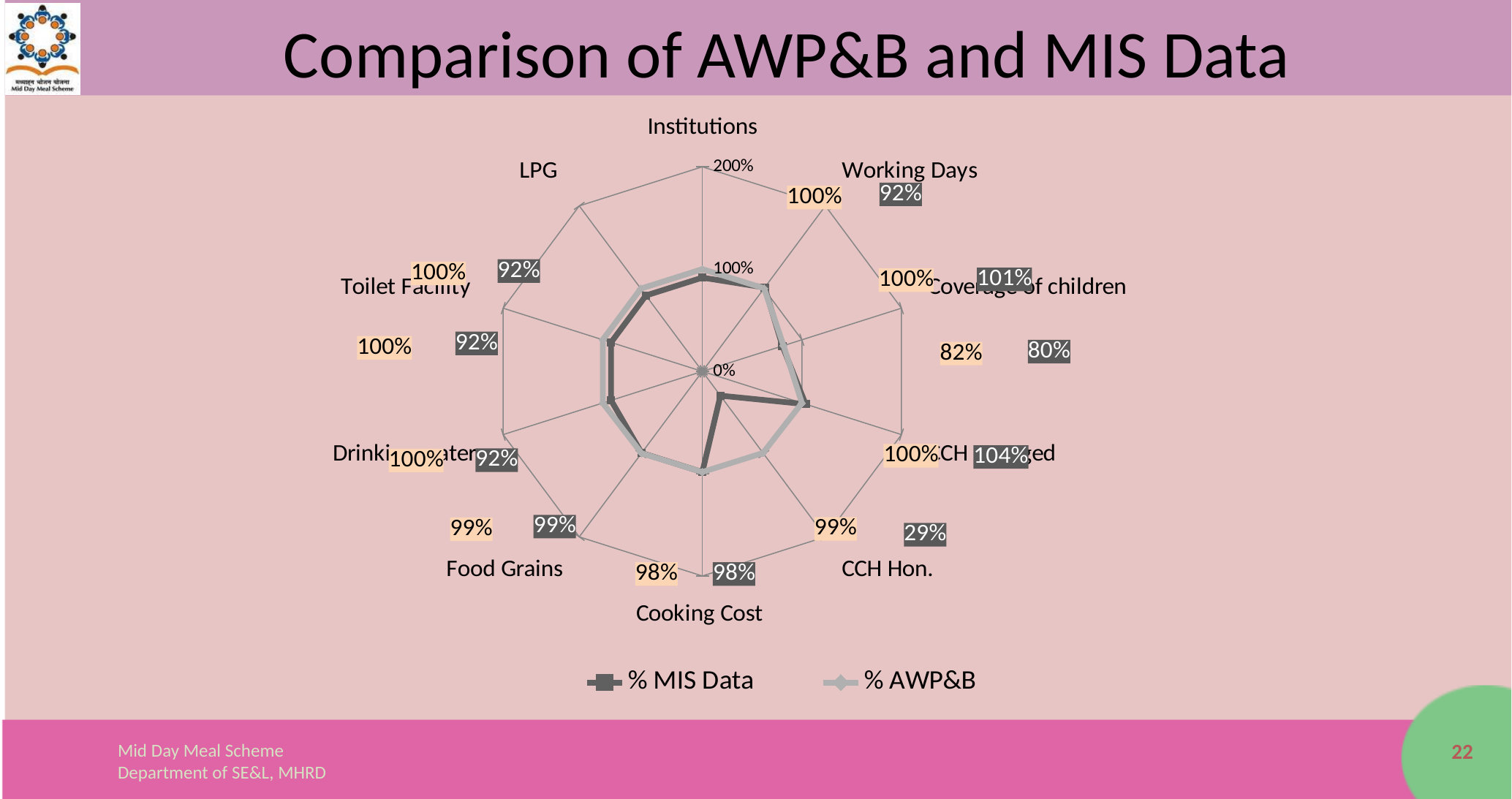
What kind of chart is shown on the slide? Radar chart What is the % MIS Data value for LPG? 92% What is the % AWP&B value for CCH Hon.? 99% What is the % MIS Data value for Cooking Cost? 98% What is the difference between the % AWP&B and % MIS Data values for Drinking Water? 8% What is the % AWP&B value for Food Grains? 99% What is the % AWP&B value for Toilet Facility? 100% What is the % MIS Data value for CCH Hon.? 29% How many series does the legend list? 2 For Toilet Facility, which series has the larger value, % MIS Data or % AWP&B? % AWP&B What is the difference between the % AWP&B and % MIS Data values for CCH Hon.? 70% Which category has the lowest % MIS Data value? CCH Hon.